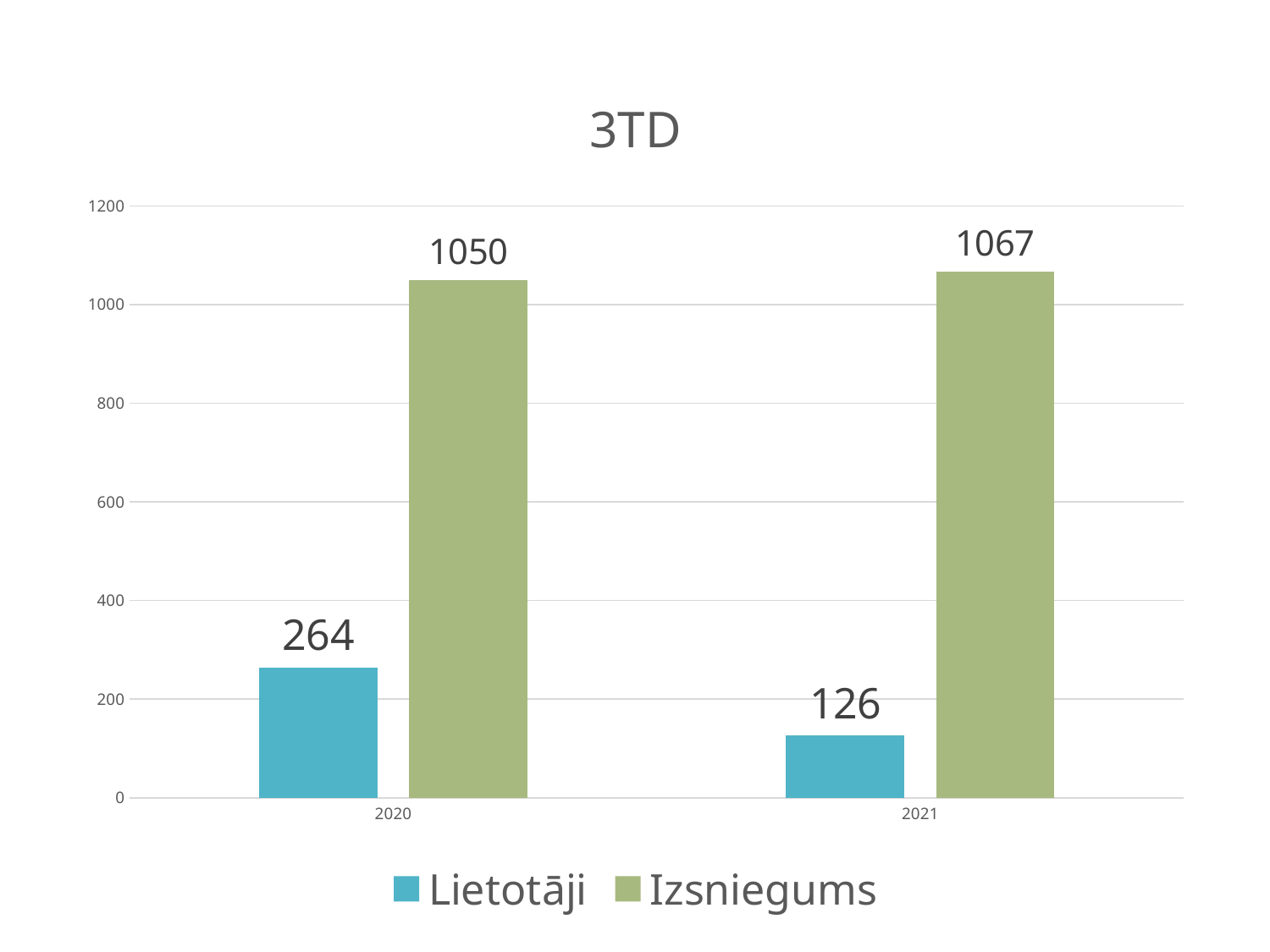
What is the difference between the Izsniegums values for 2021 and 2020? 17 How many series does the legend list? 2 What is the difference between the Lietotāji values for 2020 and 2021? 138 What is the value of Lietotāji for 2021? 126 What kind of chart is shown on the slide? Bar chart What is the value of Izsniegums for 2021? 1067 Which year has the lower Lietotāji value? 2021 Which year has the higher Izsniegums value? 2021 What is the title of the chart? 3TD Is the Lietotāji value for 2020 greater or less than 200? greater What is the value of Lietotāji for 2020? 264 What is the value of Izsniegums for 2020? 1050